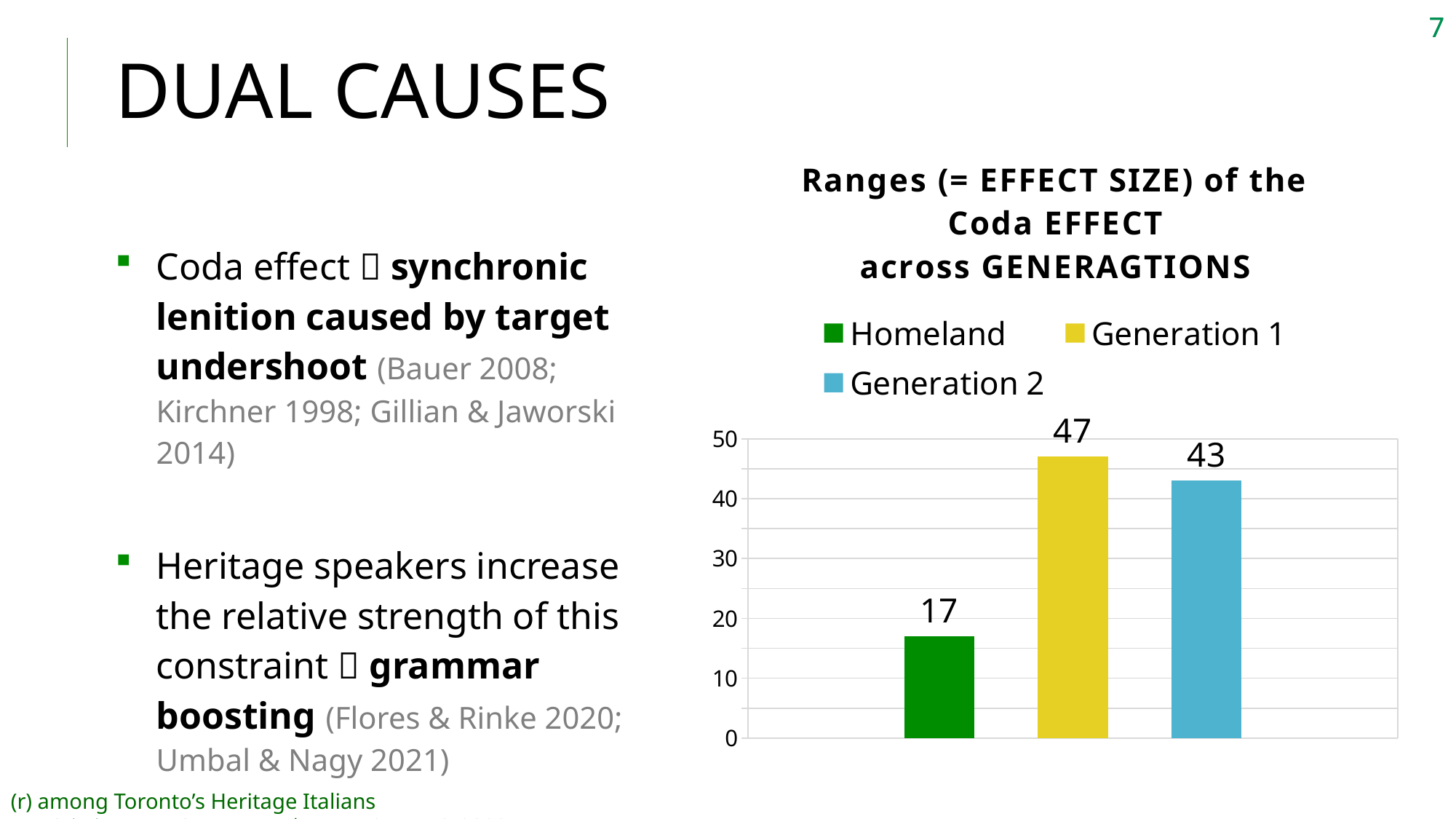
What kind of chart is shown on the slide? bar chart What is the value for Generation 1? 47 How many series does the legend list? 3 Is the value for Homeland greater or less than 20? less What is the difference between the values for Generation 1 and Generation 2? 4 What is the difference between the values for Generation 1 and Homeland? 30 What is the value for Generation 2? 43 Which series has the highest value? Generation 1 Which series has the lowest value? Homeland Which is larger, the value for Generation 2 or the value for Homeland? Generation 2 What is the value for Homeland? 17 What colour is the bar for Generation 1? yellow